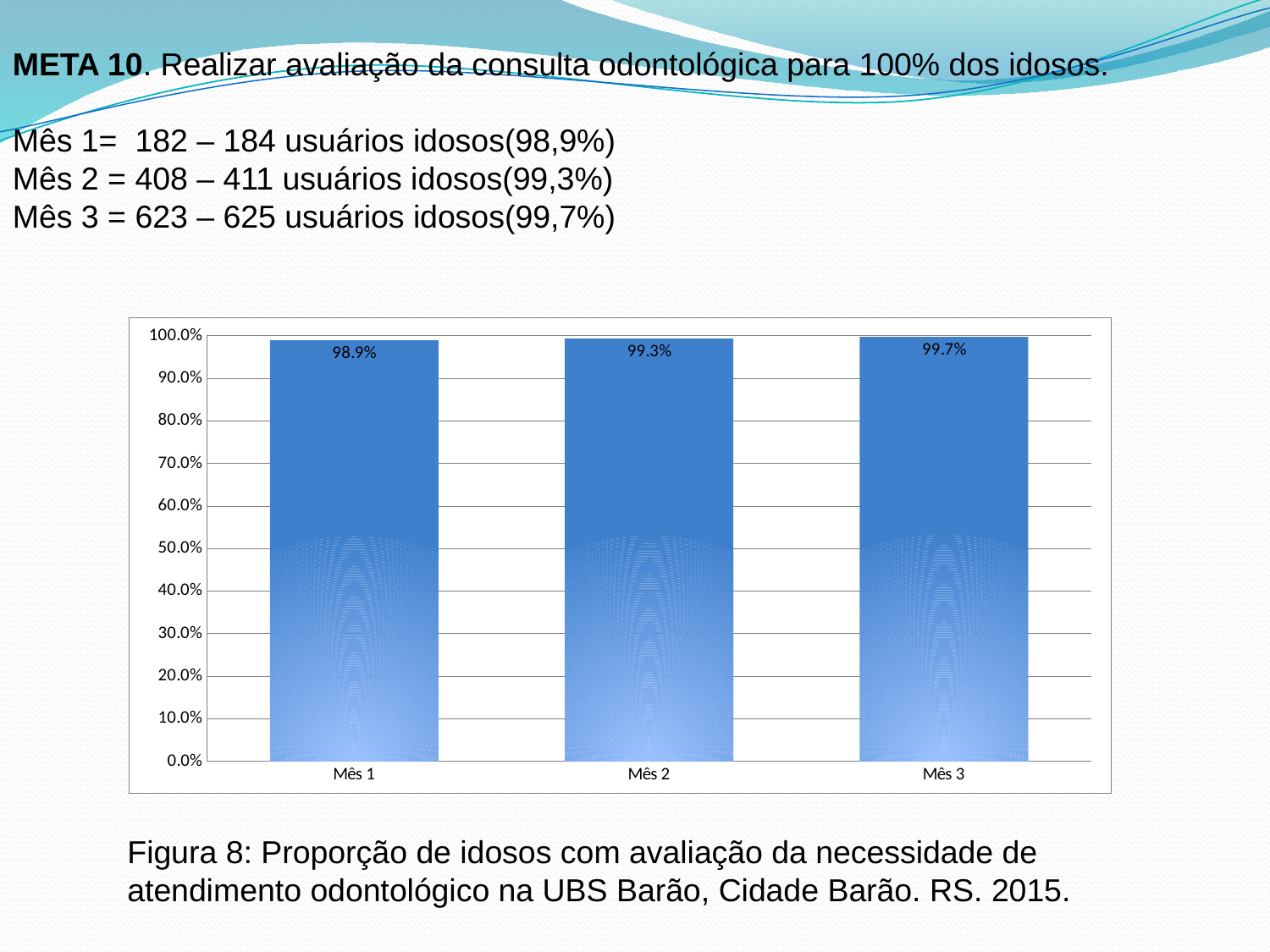
Which is larger, the value for Mês 2 or the value for Mês 3? Mês 3 What is the difference between the values for Mês 3 and Mês 1? 0.8% Is the value for Mês 1 greater or less than 90.0%? greater What kind of chart is shown? bar chart What is the value for Mês 3? 99.7% Do the values rise or fall from Mês 1 to Mês 3? rise What is the difference between the values for Mês 2 and Mês 1? 0.4% What is the value for Mês 1? 98.9% Which month has the lowest value? Mês 1 Which month has the highest value? Mês 3 What is the value for Mês 2? 99.3% How many months are shown on the x axis? 3